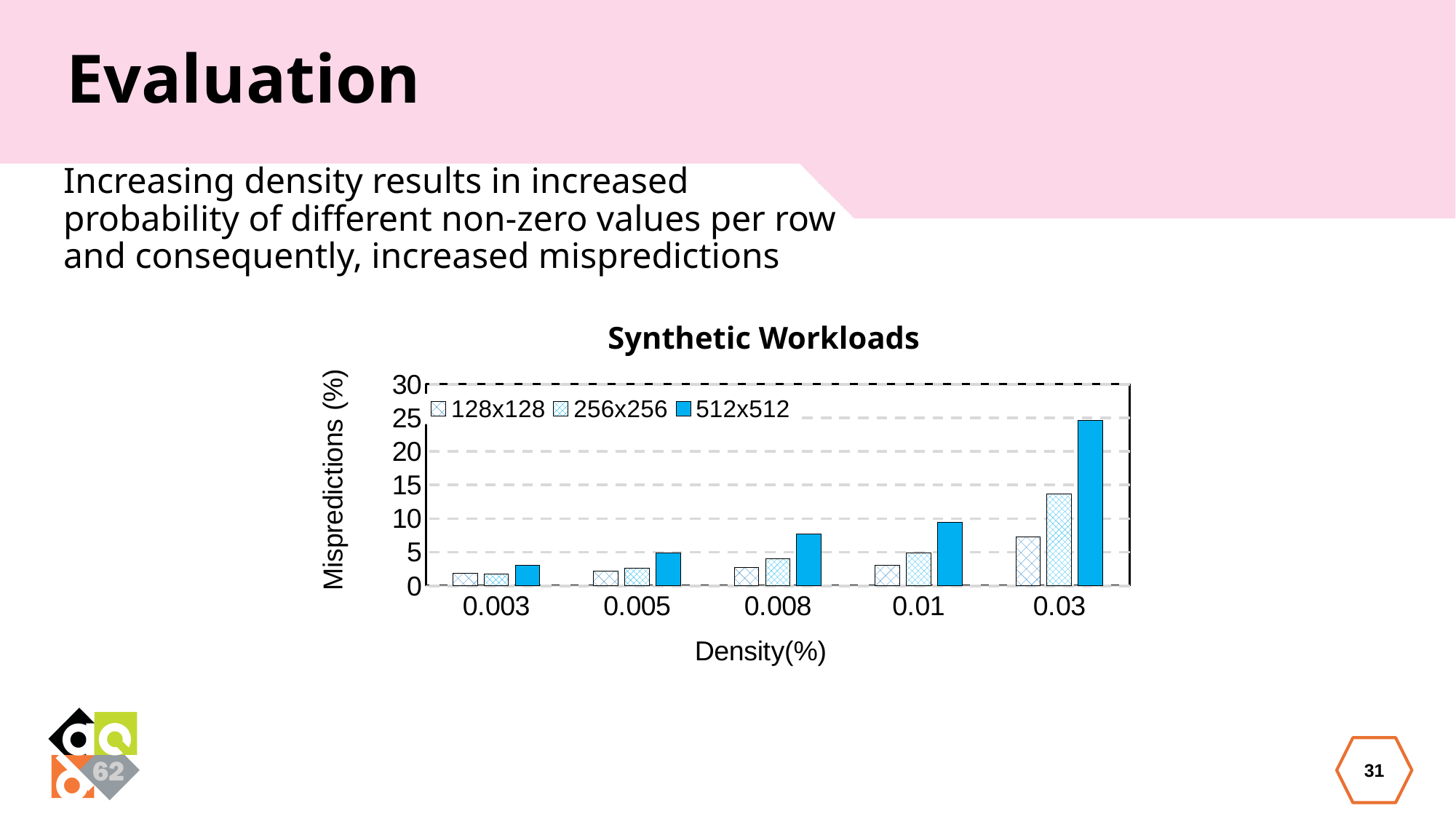
Do the 512x512 values rise or fall as density increases along the x axis? rise What is the label of the y axis? Mispredictions (%) Is the value for 512x512 at density 0.008 greater or less than 10? less What is the title of the chart? Synthetic Workloads At which density does the 512x512 series reach its highest value? 0.03 At density 0.03, which series has the larger value, 128x128 or 512x512? 512x512 How many density categories are shown on the x axis? 5 How many series does the legend list? 3 What kind of chart is shown on the slide? bar chart At which density does the 512x512 series have its lowest value? 0.003 Is the value for 256x256 at density 0.03 greater or less than 10? greater Is the value for 512x512 at density 0.03 greater or less than 20? greater